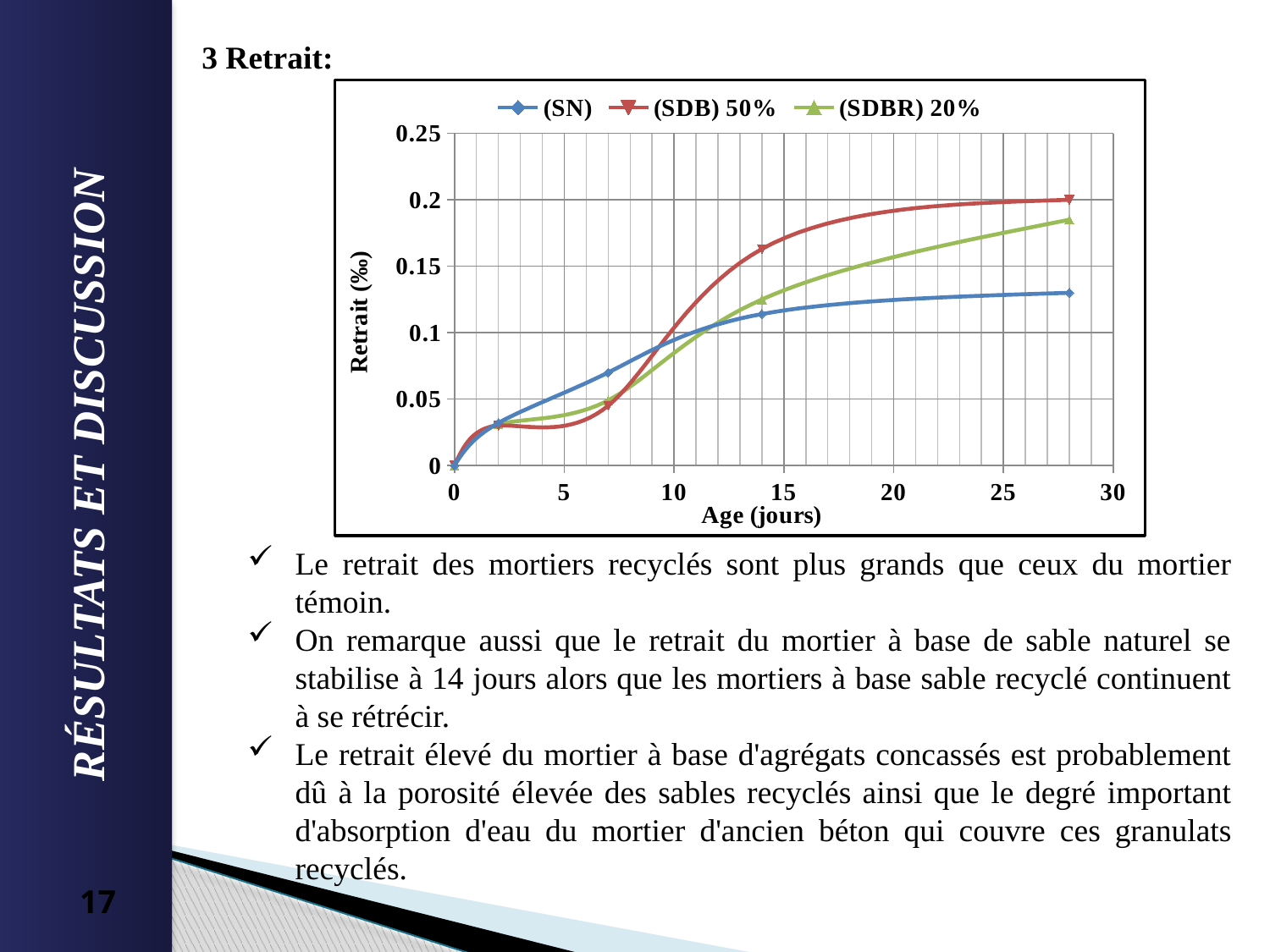
How many series does the legend list? 3 At 28 days, which series has the larger retrait value, (SN) or (SDB) 50%? (SDB) 50% What kind of chart is shown on the slide? line chart Is the retrait value for (SDB) 50% at 14 days greater or less than 0.15? greater Which series has the lowest retrait value at 28 days? (SN) Which series has the highest retrait value at 28 days? (SDB) 50% What is the label of the y axis? Retrait (‰) Is the retrait value for (SDBR) 20% at 14 days greater or less than 0.1? greater Do the retrait values for (SDBR) 20% rise or fall as age increases? rise What is the label of the x axis? Age (jours) Is the retrait value for (SN) at 28 days greater or less than 0.15? less